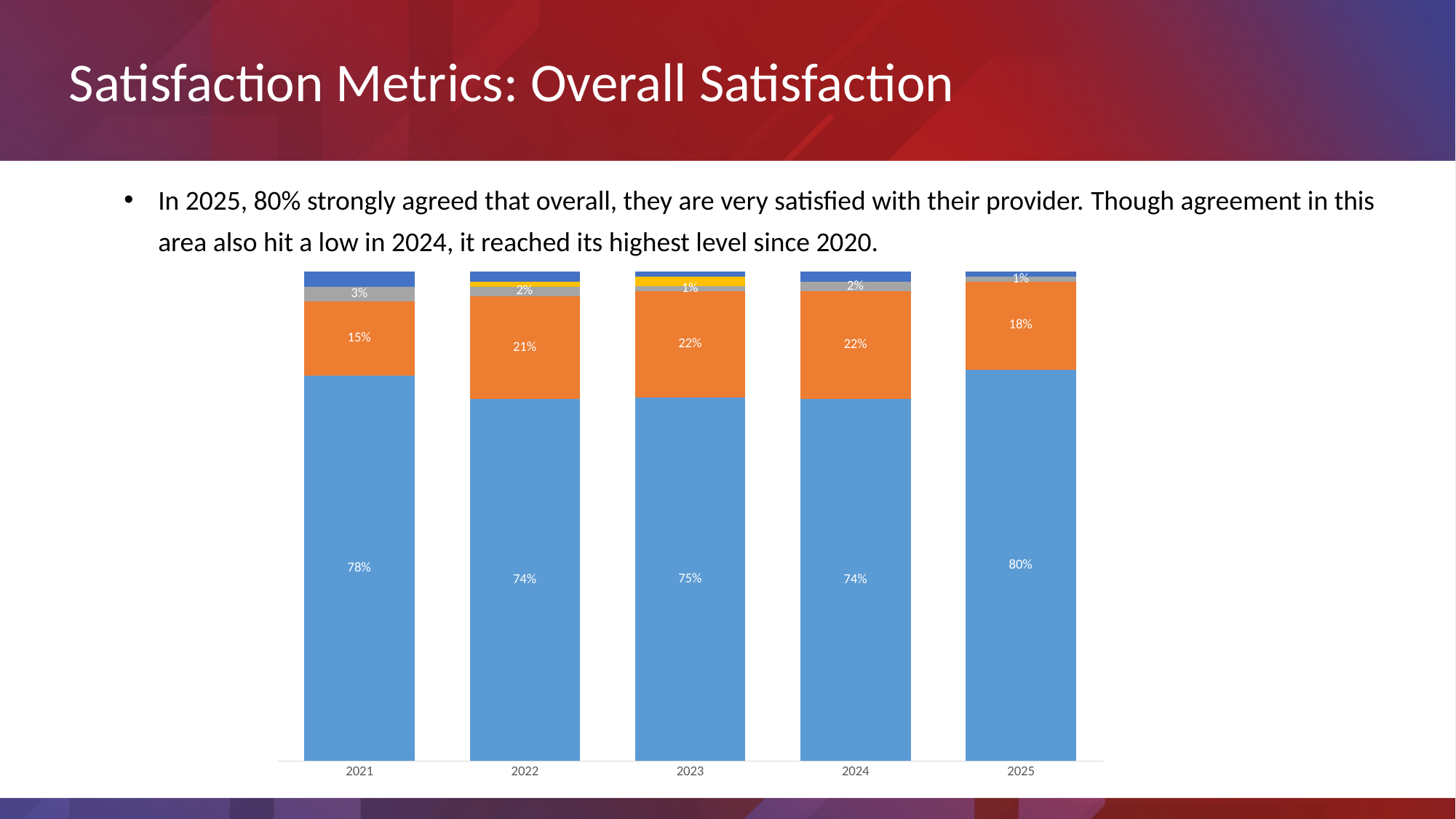
In which year is the bottom (light blue) segment the highest? 2025 By how many percentage points does the bottom (light blue) segment in 2025 exceed that in 2021? 2 percentage points What kind of chart is shown on the slide? Stacked bar chart What is the value of the gray segment for 2021? 3% What is the value of the bottom (light blue) segment for 2021? 78% How many years (categories) are shown along the x axis of the chart? 5 What is the value of the orange segment for 2022? 21% What is the difference between the orange segment in 2022 and the orange segment in 2021? 6 percentage points What is the value of the orange segment for 2025? 18% Which year has the larger bottom (light blue) segment, 2022 or 2023? 2023 In which year is the orange segment the lowest? 2021 Does the bottom (light blue) segment rise or fall from 2024 to 2025? Rise